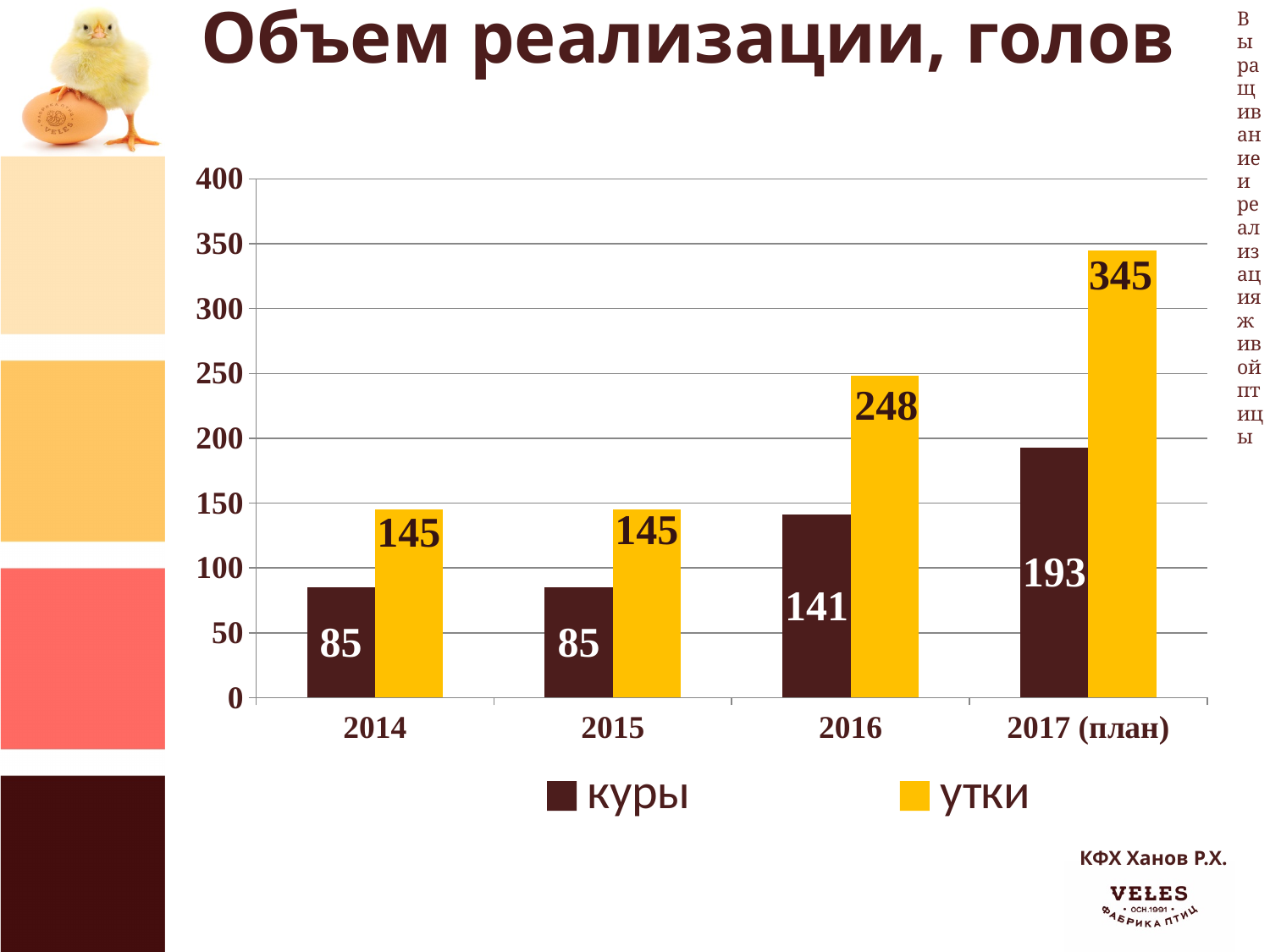
What kind of chart is shown on the slide? bar chart How many series does the legend list? 2 Which year has the lowest value for куры? 2014 and 2015 (both 85) What is the value for утки in 2017 (план)? 345 What is the value for утки in 2014? 145 Which is larger in 2017 (план): куры or утки? утки What is the title of the chart? Объем реализации, голов Which year has the highest value for утки? 2017 (план) What is the difference between утки and куры in 2016? 107 How many years are shown on the x axis? 4 What is the value for куры in 2016? 141 Is the value for утки in 2016 greater or less than 200? greater